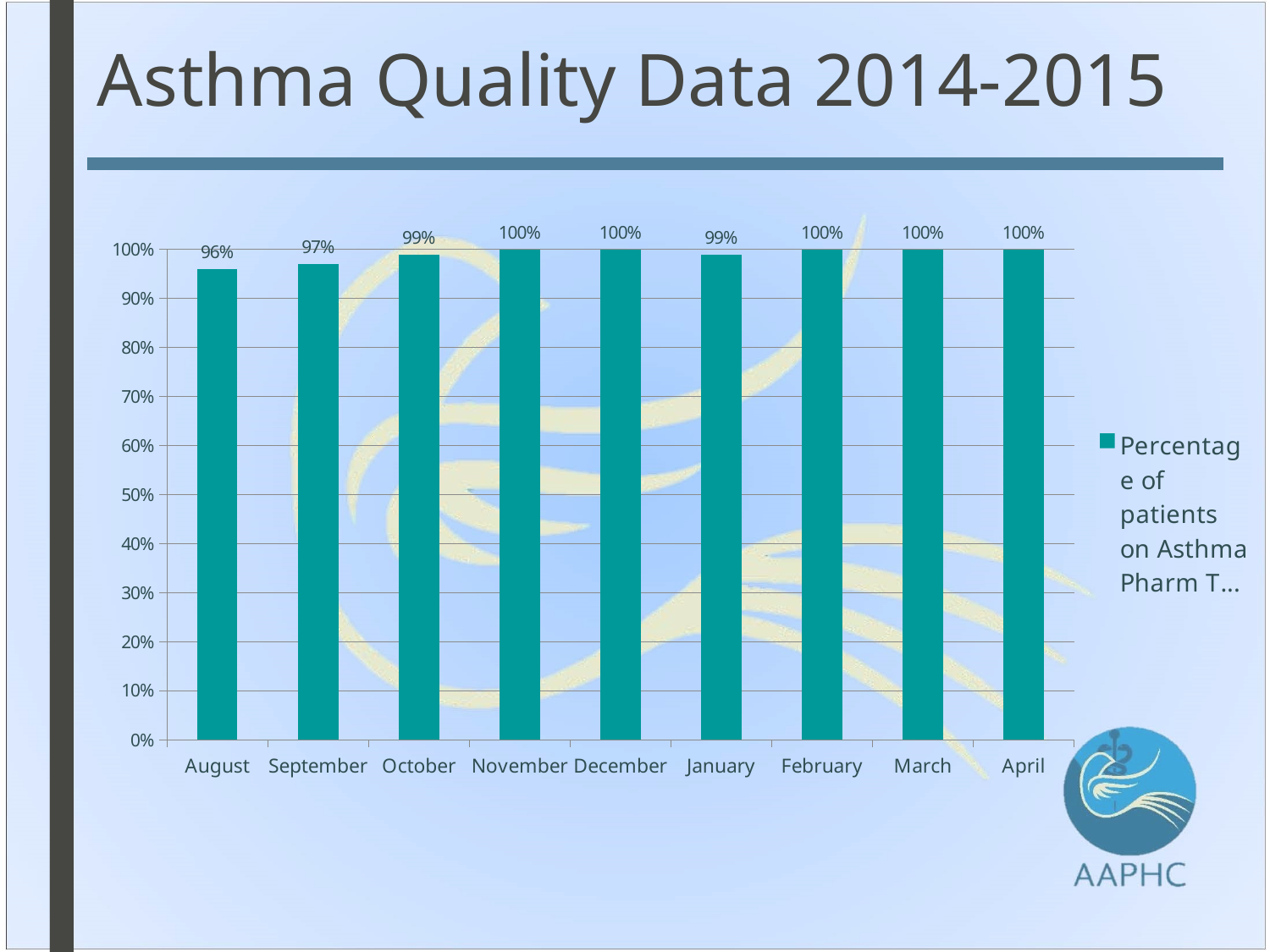
Which is larger, the value for September or the value for November? November What is the value for September? 97% What is the value for March? 100% What is the value for August? 96% Do the values generally rise or fall from August to November? rise Which month has the lowest value? August Is the value for August greater or less than 90%? greater How many series does the legend list? 1 What is the value for January? 99% How many months are shown on the x axis? 9 What kind of chart is shown on the slide? bar chart What is the difference between the values for October and August? 3%